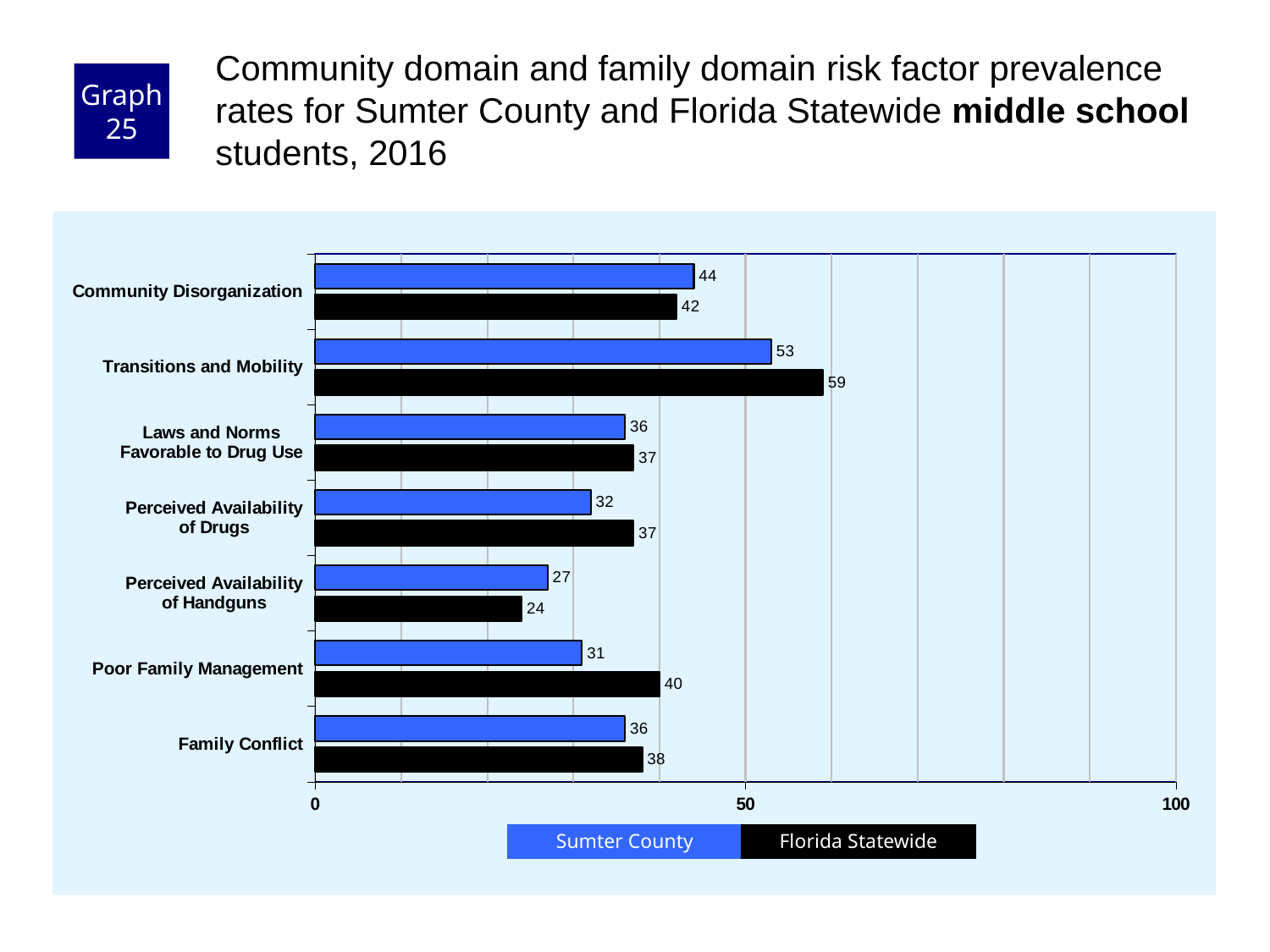
Is the Florida Statewide value for Transitions and Mobility greater or less than 50? greater What is the difference between the Florida Statewide and Sumter County values for Poor Family Management? 9 What is the Sumter County value for Community Disorganization? 44 Which risk factor has the lowest Sumter County value? Perceived Availability of Handguns What is the Florida Statewide value for Poor Family Management? 40 What is the Sumter County value for Perceived Availability of Handguns? 27 Which is larger for Transitions and Mobility: the Sumter County value or the Florida Statewide value? Florida Statewide How many series does the legend list? 2 How many risk factor categories are shown on the chart? 7 Which colour represents Florida Statewide in the chart? black Which risk factor has the highest Florida Statewide value? Transitions and Mobility What kind of chart is shown on the slide? bar chart